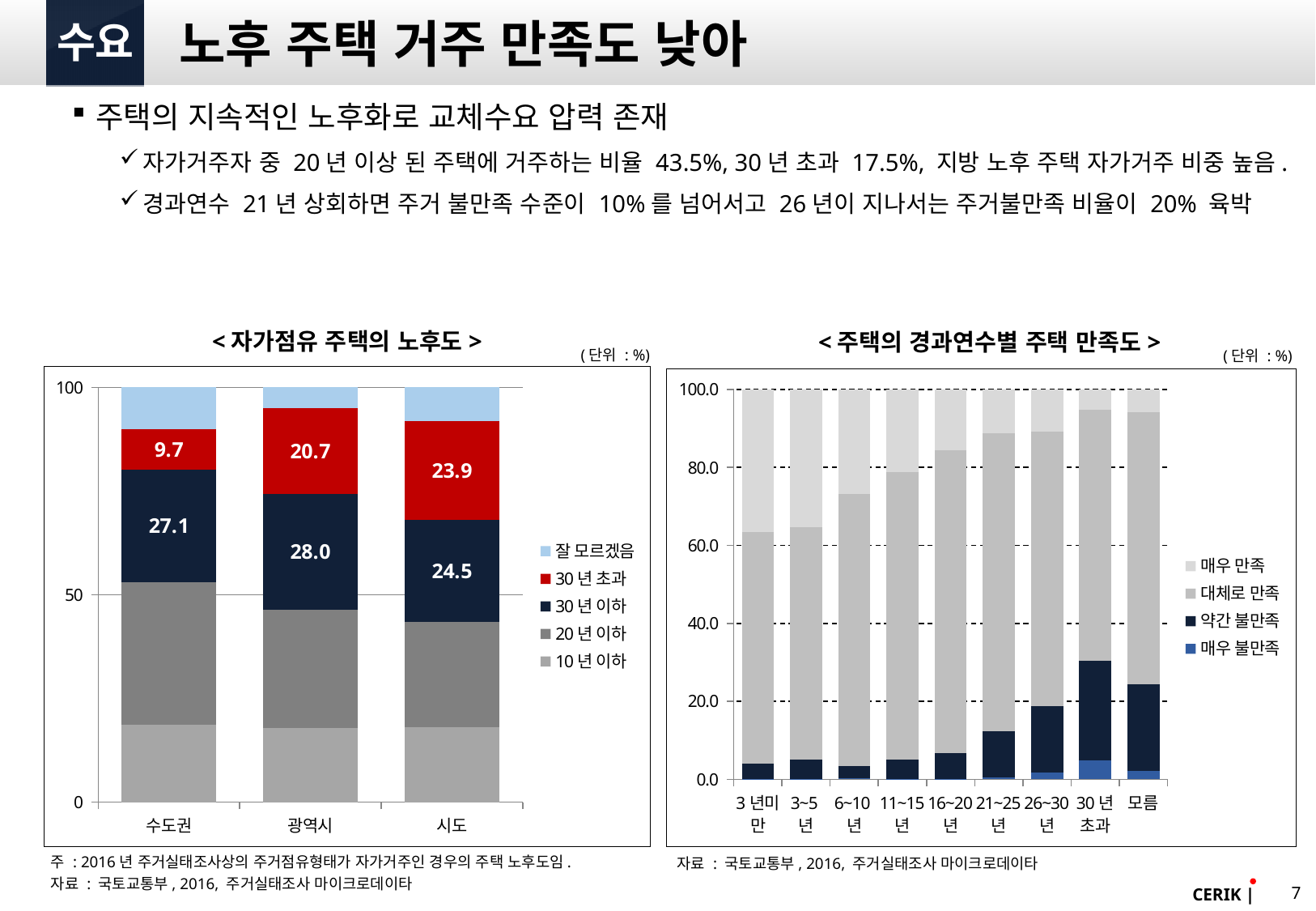
In the chart titled '< 자가점유 주택의 노후도 >', what is the difference between the '30 년 초과' values for 시도 and 수도권? 14.2 In the chart titled '< 자가점유 주택의 노후도 >', which region has the highest '30 년 초과' value? 시도 In the chart titled '< 자가점유 주택의 노후도 >', what is the value of '30 년 초과' for 수도권? 9.7 What kind of chart is the chart titled '< 주택의 경과연수별 주택 만족도 >'? Stacked bar chart In the chart titled '< 자가점유 주택의 노후도 >', which region has the lowest '30 년 초과' value? 수도권 In the chart titled '< 자가점유 주택의 노후도 >', what is the value of '30 년 이하' for 광역시? 28.0 How many categories are shown on the x axis of the chart titled '< 자가점유 주택의 노후도 >'? 3 How many categories are shown on the x axis of the chart titled '< 주택의 경과연수별 주택 만족도 >'? 9 How many series does the legend of the chart titled '< 자가점유 주택의 노후도 >' list? 5 In the chart titled '< 자가점유 주택의 노후도 >', what is the value of '30 년 초과' for 시도? 23.9 In the chart titled '< 주택의 경과연수별 주택 만족도 >', does the '약간 불만족' segment generally rise or fall from '3 년미만' to '30 년 초과'? Rise In the chart titled '< 자가점유 주택의 노후도 >', which has the larger '30 년 이하' value, 수도권 or 시도? 수도권